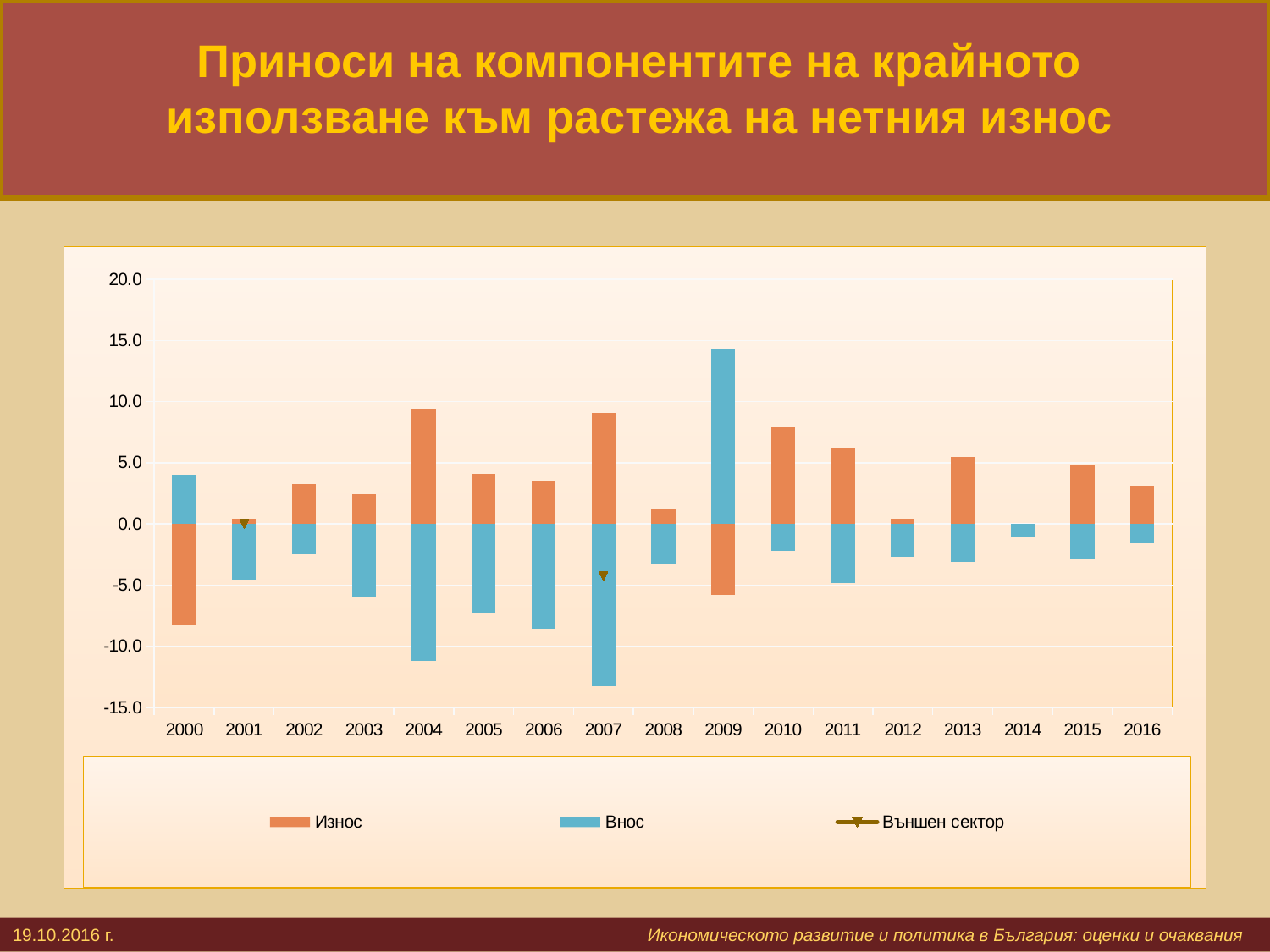
Is the value for Износ in 2000 greater or less than -5.0? less What kind of chart is shown on the slide? combination bar and line chart Is the value for Внос in 2007 greater or less than -10.0? less How many series does the legend list? 3 Which year has the highest value for Внос? 2009 Is the value for Внос in 2009 greater or less than 10.0? greater Does the value for Износ rise or fall from 2010 to 2012? fall Which is larger, the value for Износ in 2010 or in 2013? 2010 How many years are shown on the x axis? 17 Which year has the lowest value for Износ? 2000 Which year has the lowest value for Внос? 2007